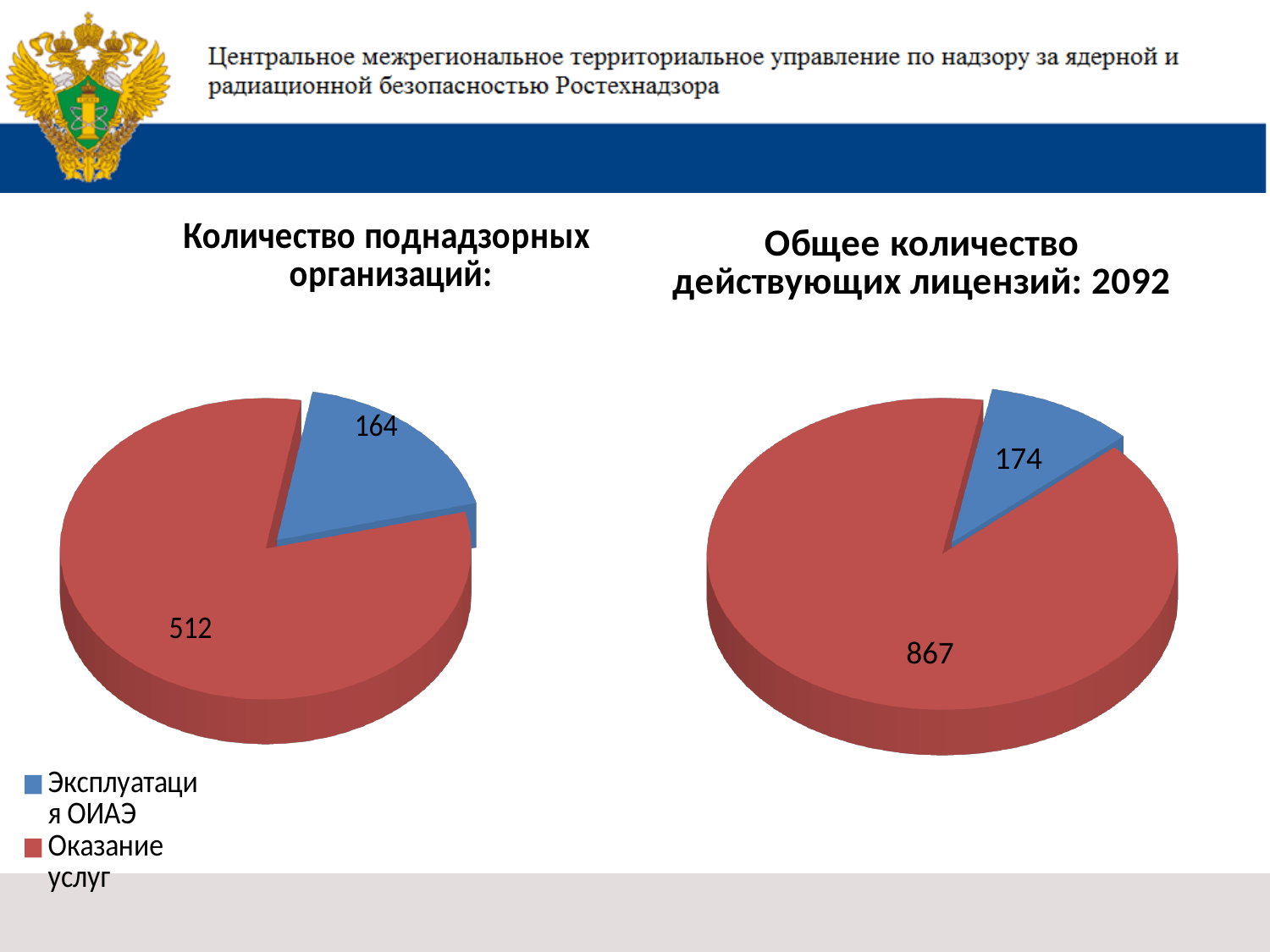
What kind of chart is the left chart 'Количество поднадзорных организаций'? pie chart Which colour represents 'Эксплуатация ОИАЭ' in the pie charts? blue How many entries does the legend on the slide list? 2 In the left chart 'Количество поднадзорных организаций', what is the difference between 'Оказание услуг' and 'Эксплуатация ОИАЭ'? 348 In the right chart 'Общее количество действующих лицензий', what is the value for 'Оказание услуг'? 867 In the left chart 'Количество поднадзорных организаций', which category has the largest slice? Оказание услуг In the left chart 'Количество поднадзорных организаций', what is the value for 'Эксплуатация ОИАЭ'? 164 In the right chart 'Общее количество действующих лицензий', what is the difference between 'Оказание услуг' and 'Эксплуатация ОИАЭ'? 693 Is the value for 'Эксплуатация ОИАЭ' larger in the left chart or in the right chart? right chart In the right chart 'Общее количество действующих лицензий', what is the value for 'Эксплуатация ОИАЭ'? 174 In the right chart 'Общее количество действующих лицензий', which category has the smallest slice? Эксплуатация ОИАЭ In the left chart 'Количество поднадзорных организаций', what is the value for 'Оказание услуг'? 512